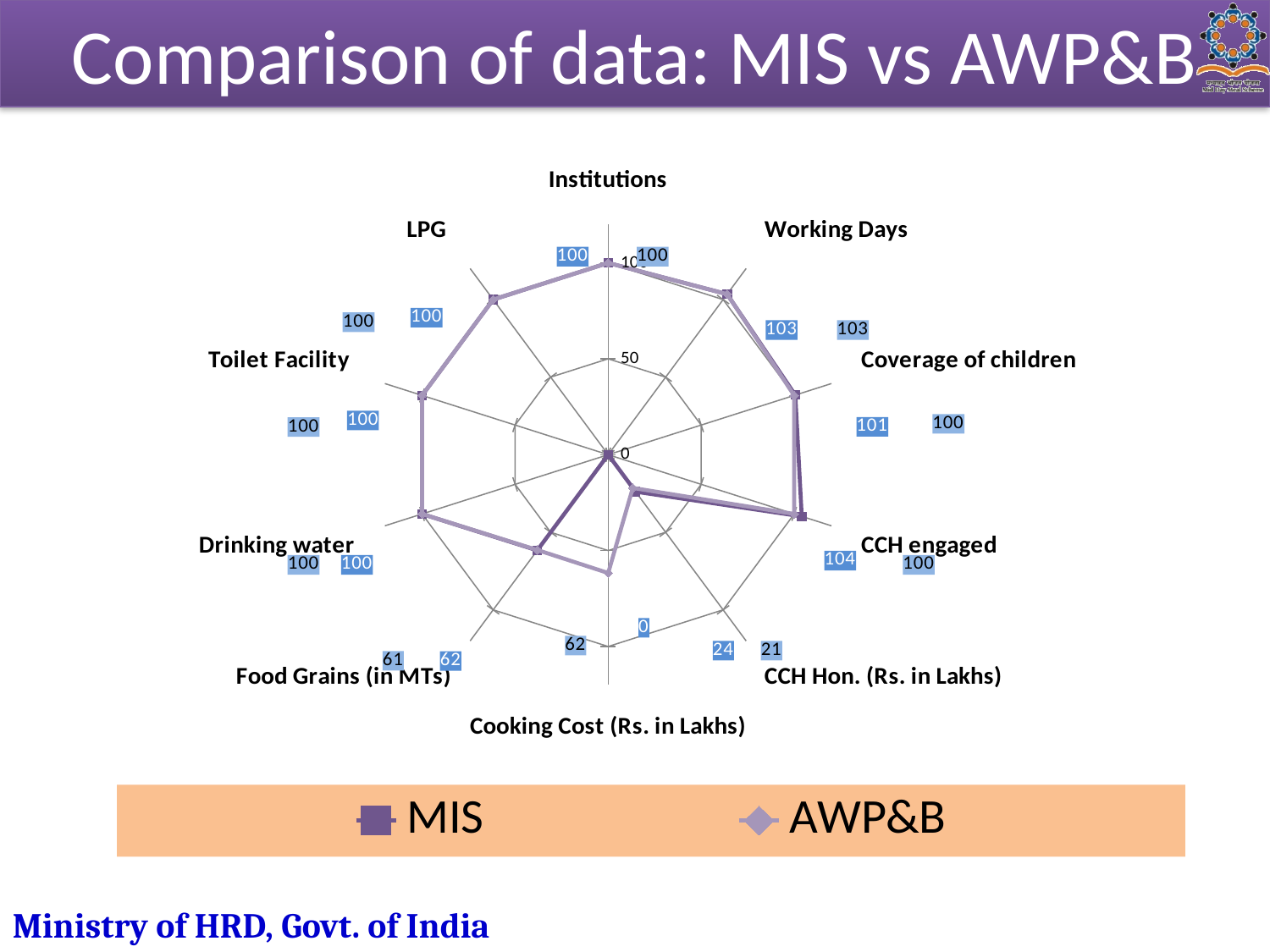
Which category has lower values, Working Days or CCH Hon. (Rs. in Lakhs)? CCH Hon. (Rs. in Lakhs) What kind of chart is shown on the slide? Radar chart How many categories (axes) does the radar chart have? 10 What value is shown for Drinking water for both series? 100 How many series does the legend list? 2 What value is shown for Institutions for both MIS and AWP&B? 100 What are the two series named in the legend? MIS and AWP&B What value is shown for Working Days for both series? 103 Are the values for Toilet Facility greater or less than 50? greater Are the values for CCH Hon. (Rs. in Lakhs) greater or less than 50? less Which category has higher values, Food Grains (in MTs) or LPG? LPG What is the title of the slide containing the chart? Comparison of data: MIS vs AWP&B